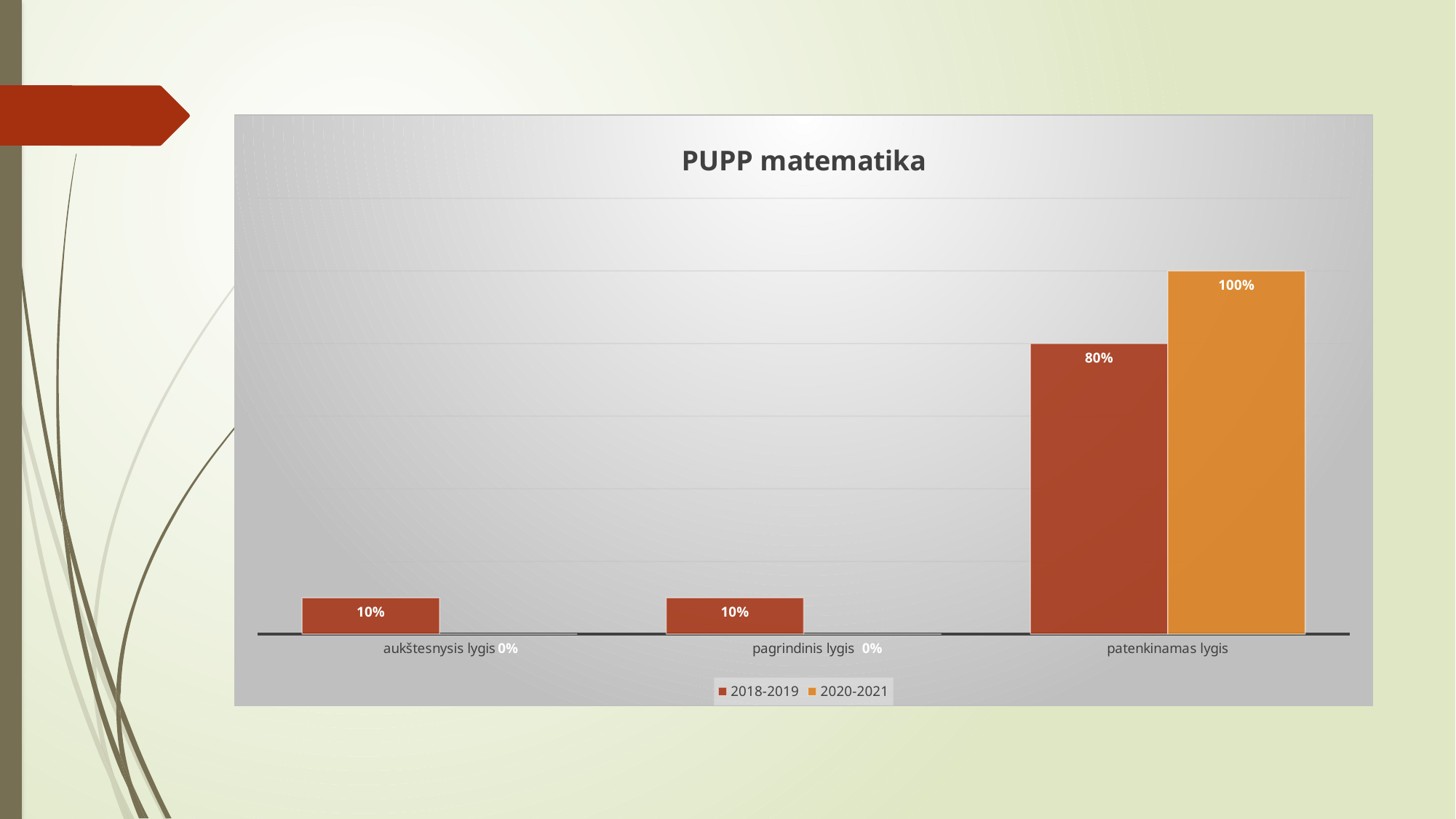
What is the value for 2018-2019 in the aukštesnysis lygis category? 10% What is the difference between the 2020-2021 and 2018-2019 values for patenkinamas lygis? 20% What type of chart is shown on the slide? bar chart What is the title of the chart? PUPP matematika What is the value for 2018-2019 in the patenkinamas lygis category? 80% How many series does the legend list? 2 What is the value for 2020-2021 in the pagrindinis lygis category? 0% For patenkinamas lygis, which series has the larger value, 2018-2019 or 2020-2021? 2020-2021 Which series is shown in orange in the legend? 2020-2021 What is the value for 2020-2021 in the patenkinamas lygis category? 100% How many categories are shown on the x axis? 3 Which category has the highest value for the 2018-2019 series? patenkinamas lygis